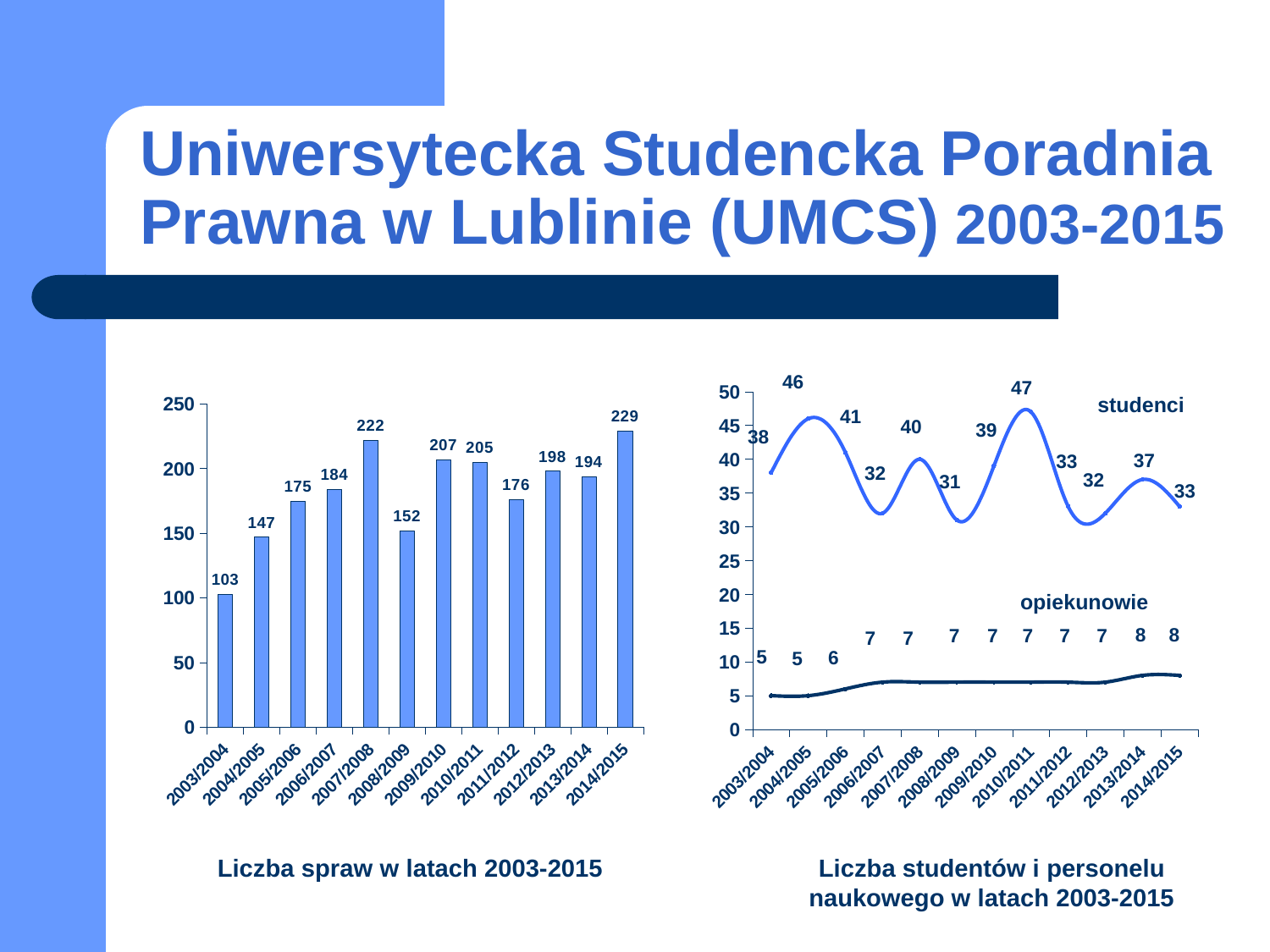
In the left chart (Liczba spraw w latach 2003-2015), how many bars are plotted? 12 How many series are shown in the right chart (Liczba studentów i personelu naukowego w latach 2003-2015)? 2 In the right chart (Liczba studentów i personelu naukowego w latach 2003-2015), what is the value for studenci in 2010/2011? 47 In the left chart (Liczba spraw w latach 2003-2015), which year has the lowest value? 2003/2004 In the right chart (Liczba studentów i personelu naukowego w latach 2003-2015), what is the difference between studenci and opiekunowie in 2014/2015? 25 In the right chart (Liczba studentów i personelu naukowego w latach 2003-2015), in which year is the studenci value lowest? 2008/2009 In the left chart (Liczba spraw w latach 2003-2015), what is the value for 2007/2008? 222 In the left chart (Liczba spraw w latach 2003-2015), what is the difference between the values for 2014/2015 and 2003/2004? 126 In the left chart (Liczba spraw w latach 2003-2015), which is larger, the value for 2009/2010 or 2010/2011? 2009/2010 In the left chart (Liczba spraw w latach 2003-2015), which year has the highest value? 2014/2015 What type of chart is the left chart (Liczba spraw w latach 2003-2015)? bar chart In the right chart (Liczba studentów i personelu naukowego w latach 2003-2015), what is the value for opiekunowie in 2003/2004? 5